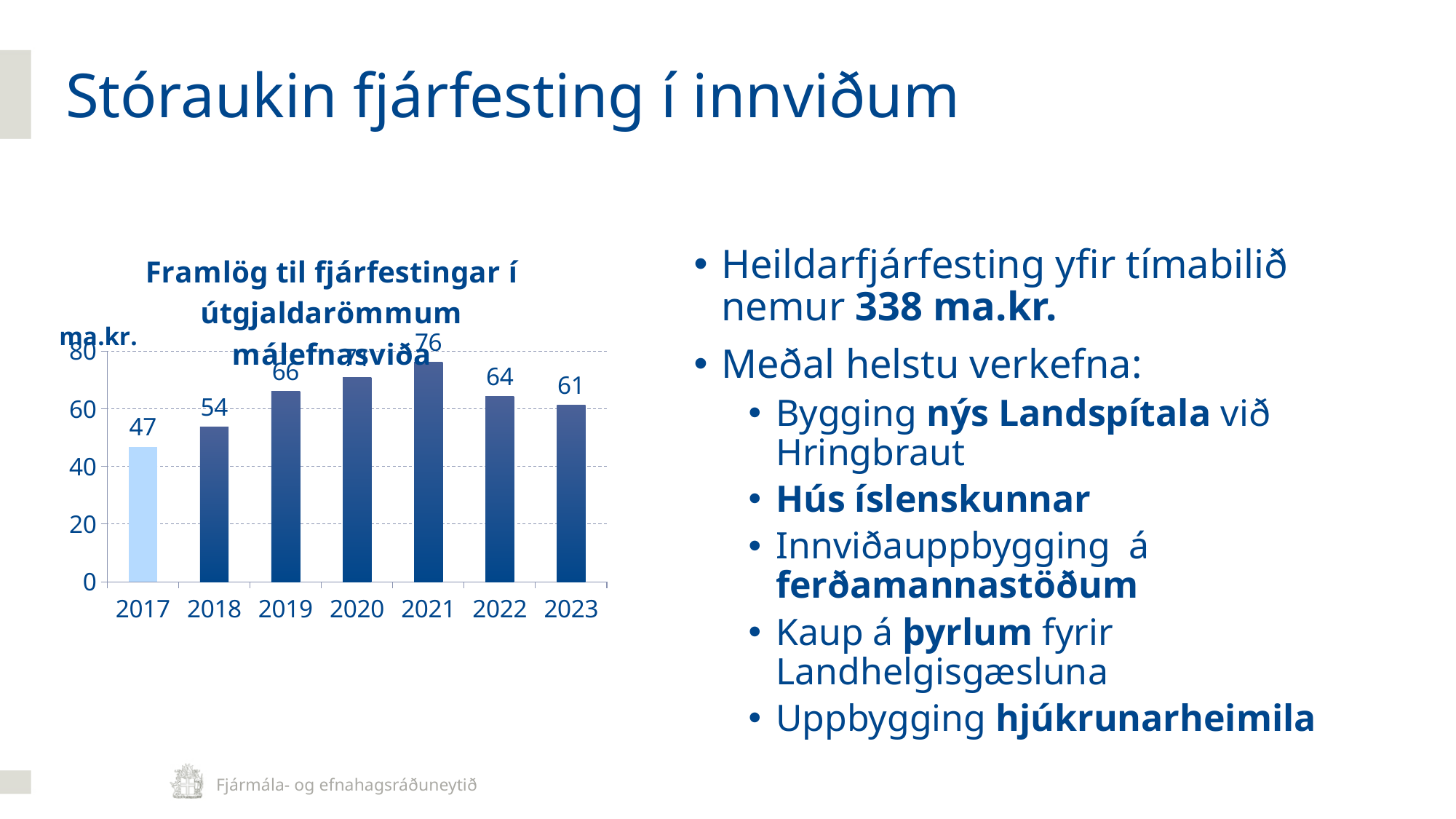
What is the value for 2017 in the chart? 47 Is the value for 2020 greater or less than 60? greater Do the values rise or fall from 2017 to 2021? rise How many years are shown on the x axis of the chart? 7 What is the value for 2021 in the chart? 76 What is the difference between the values for 2021 and 2017? 29 What unit is shown on the chart's vertical axis? ma.kr. Which is larger, the value for 2018 or the value for 2022? 2022 Which year has the lowest value in the chart? 2017 What is the value for 2023 in the chart? 61 What kind of chart is shown on the slide? bar chart Which year has the highest value in the chart? 2021